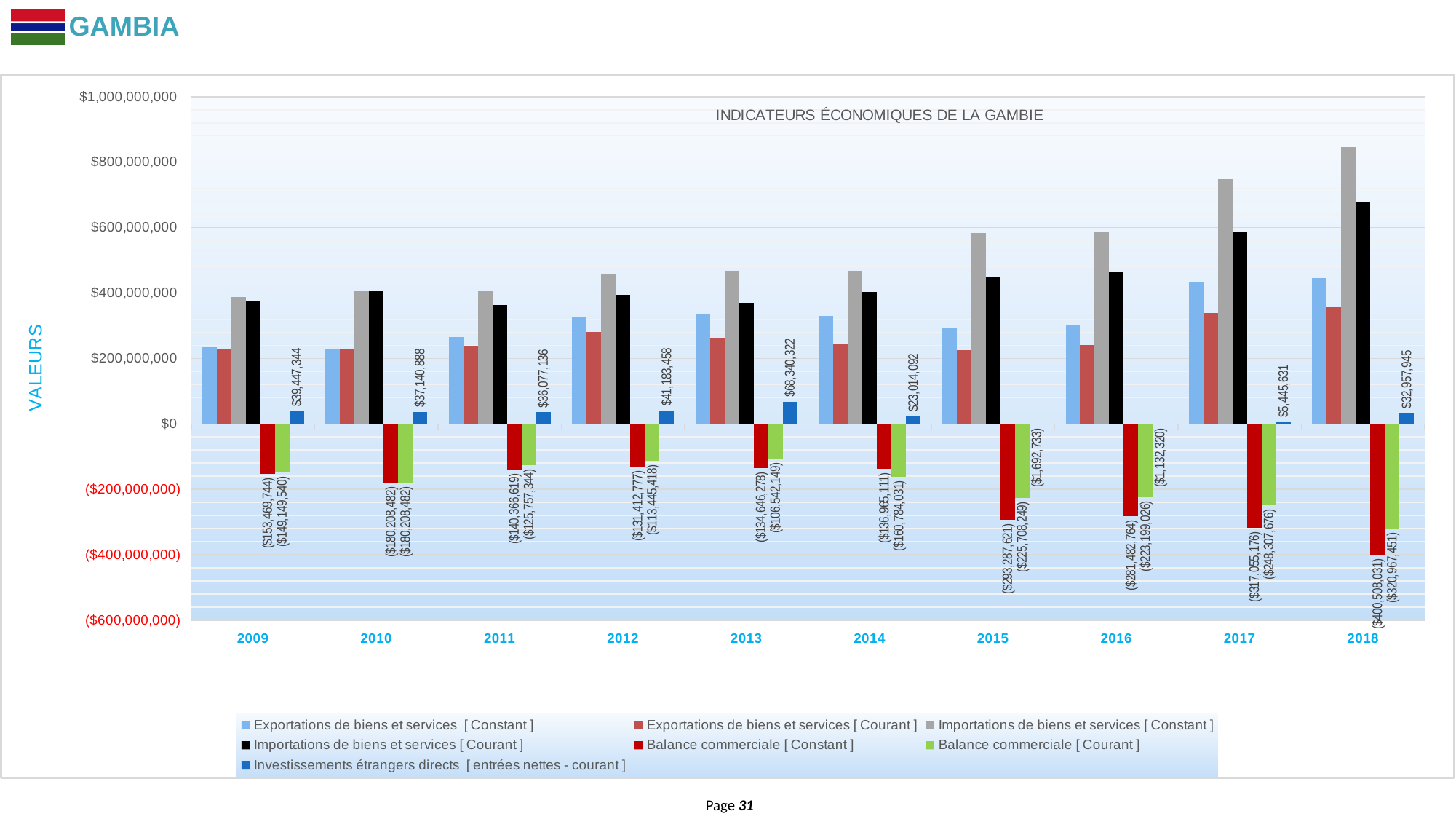
What is the value of Investissements étrangers directs [entrées nettes - courant] for 2013? $68,340,322 In which year is Investissements étrangers directs [entrées nettes - courant] the highest? 2013 What is the title of the chart? INDICATEURS ÉCONOMIQUES DE LA GAMBIE What kind of chart is shown on the slide? Bar chart What is the difference between Investissements étrangers directs for 2009 and 2010? $2,306,456 Is the value of Importations de biens et services [Constant] for 2018 greater or less than $800,000,000? greater How many years are shown on the x axis of the chart? 10 In which year is Investissements étrangers directs [entrées nettes - courant] the lowest? 2015 What is the value of Balance commerciale [Courant] for 2015? ($225,708,249) Which year has the larger value of Investissements étrangers directs: 2011 or 2012? 2012 What is the value of Balance commerciale [Constant] for 2018? ($400,508,031) How many series does the legend list? 7